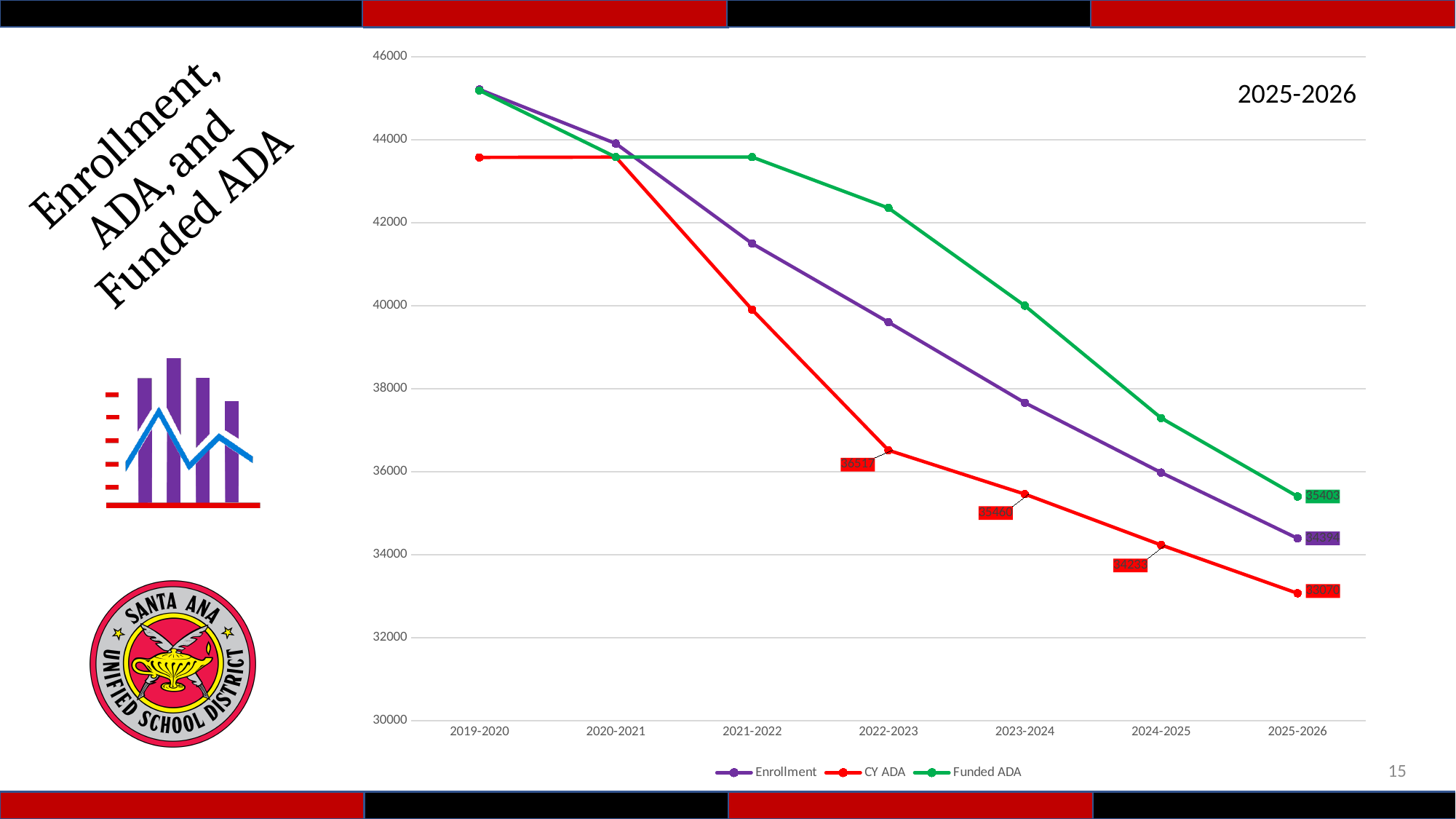
What is the difference between Funded ADA and CY ADA in 2025-2026? 2333 What is the CY ADA value for 2025-2026? 33070 Which series is drawn in green in the chart? Funded ADA Which series has the highest value in 2025-2026? Funded ADA Is the Enrollment value for 2019-2020 greater or less than 44000? greater Does the Enrollment line rise or fall from 2019-2020 to 2025-2026? fall What kind of chart is shown on the slide? line chart How many series does the chart's legend list? 3 What is the Enrollment value for 2025-2026? 34394 What is the Funded ADA value for 2025-2026? 35403 Which series has the lowest value in 2025-2026? CY ADA How many school years are shown along the x axis of the chart? 7